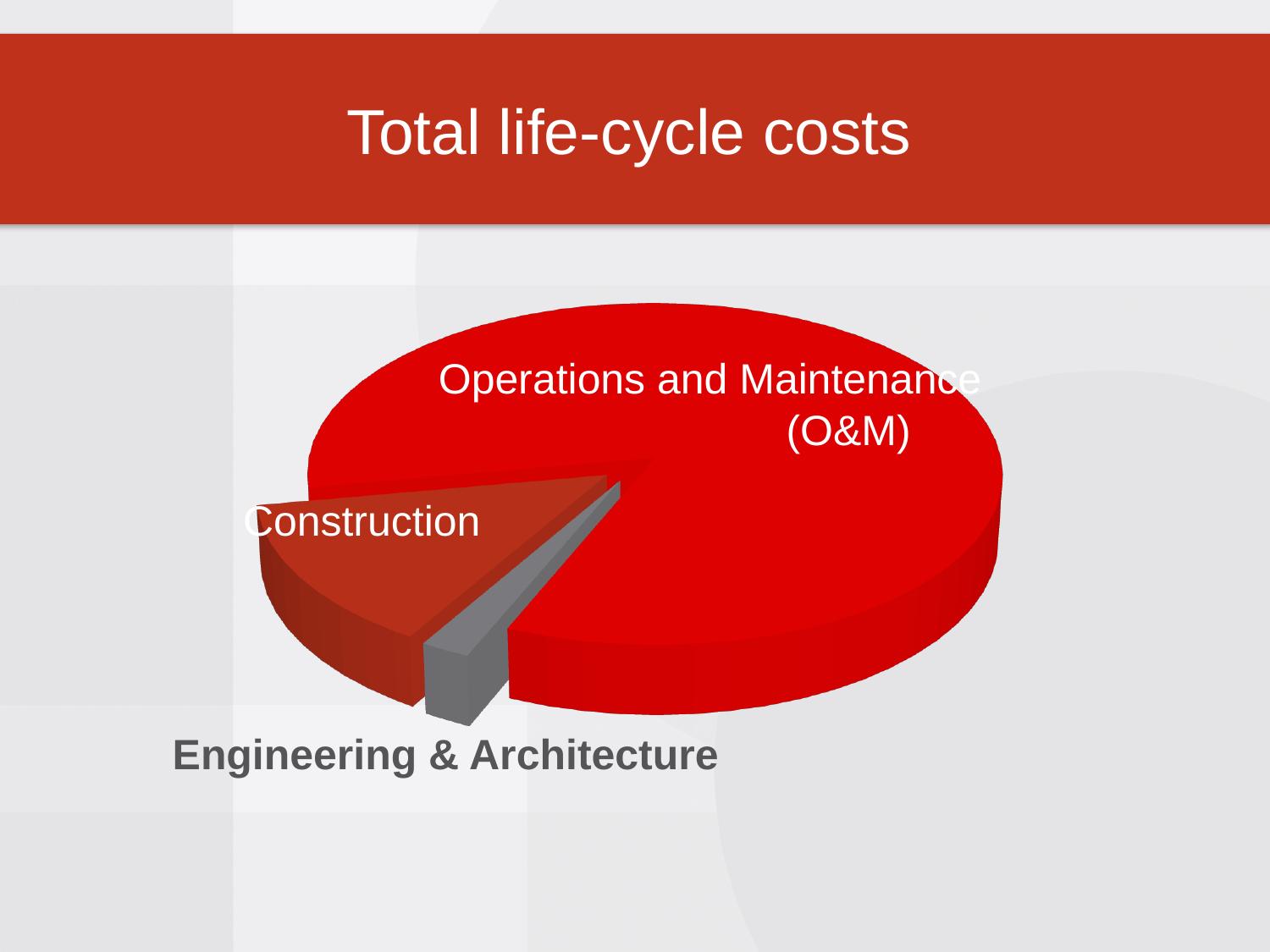
Which slice is larger, Construction or Engineering & Architecture? Construction What kind of chart is shown on the slide? Pie chart Does the Operations and Maintenance (O&M) slice take up more or less than half of the pie? More What colour is the Engineering & Architecture slice of the pie chart? Gray What is the title of the slide containing the pie chart? Total life-cycle costs Which slice of the pie chart is the largest? Operations and Maintenance (O&M) Which slice of the pie chart is the smallest? Engineering & Architecture Which slice is larger, Operations and Maintenance (O&M) or Construction? Operations and Maintenance (O&M) How many slices does the pie chart have? 3